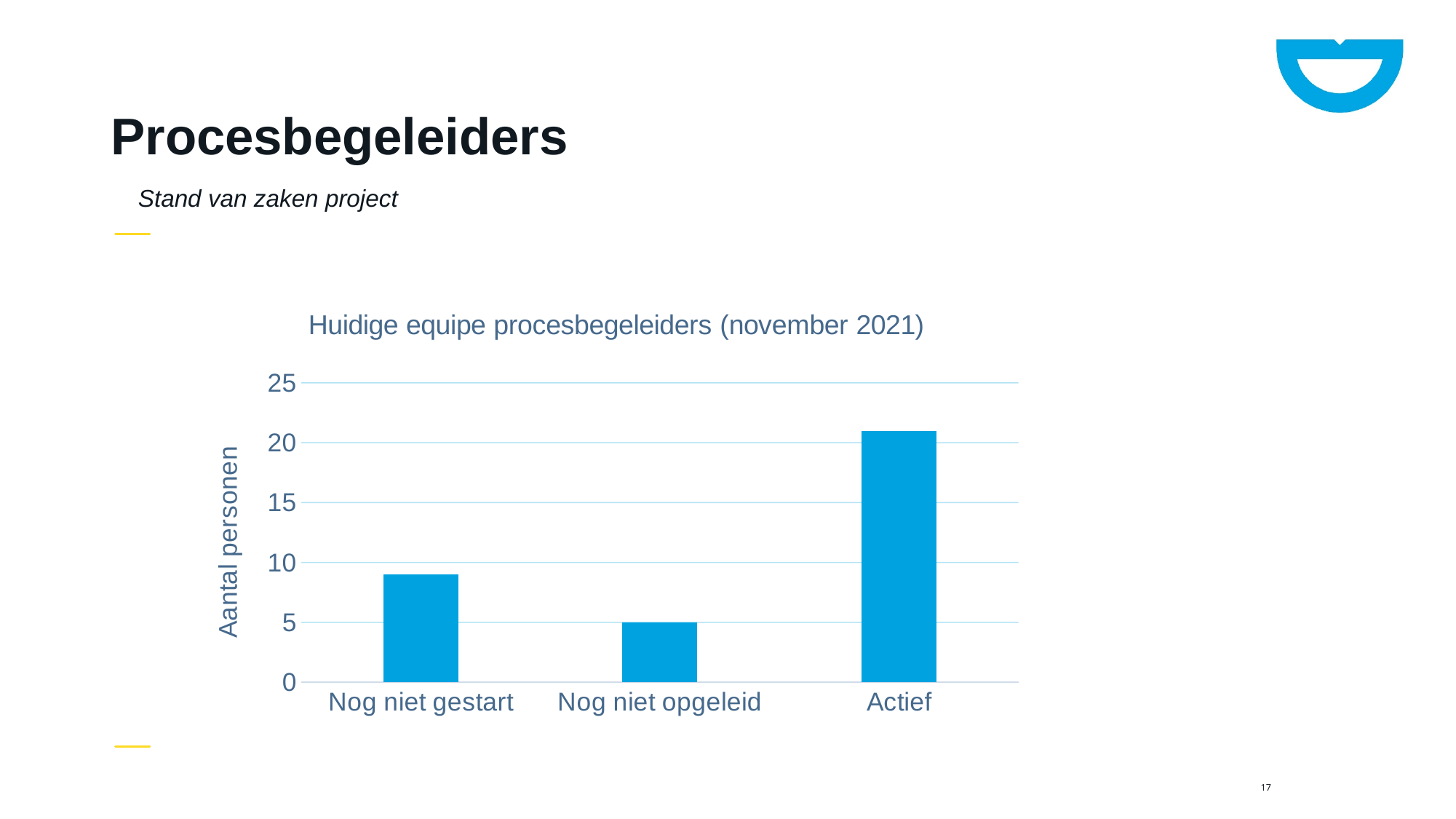
Which category has the lowest value? Nog niet opgeleid What is the title of the chart? Huidige equipe procesbegeleiders (november 2021) Which is larger, the value for Nog niet gestart or the value for Nog niet opgeleid? Nog niet gestart What kind of chart is shown on the slide? bar chart Is the value for Actief greater or less than 20? greater What is the label of the vertical axis? Aantal personen What is the value for Nog niet opgeleid? 5 Which is larger, the value for Actief or the value for Nog niet gestart? Actief How many categories are shown on the x axis of the chart? 3 Is the value for Nog niet gestart greater or less than 10? less Which category has the highest value? Actief Is the value for Actief greater or less than 25? less